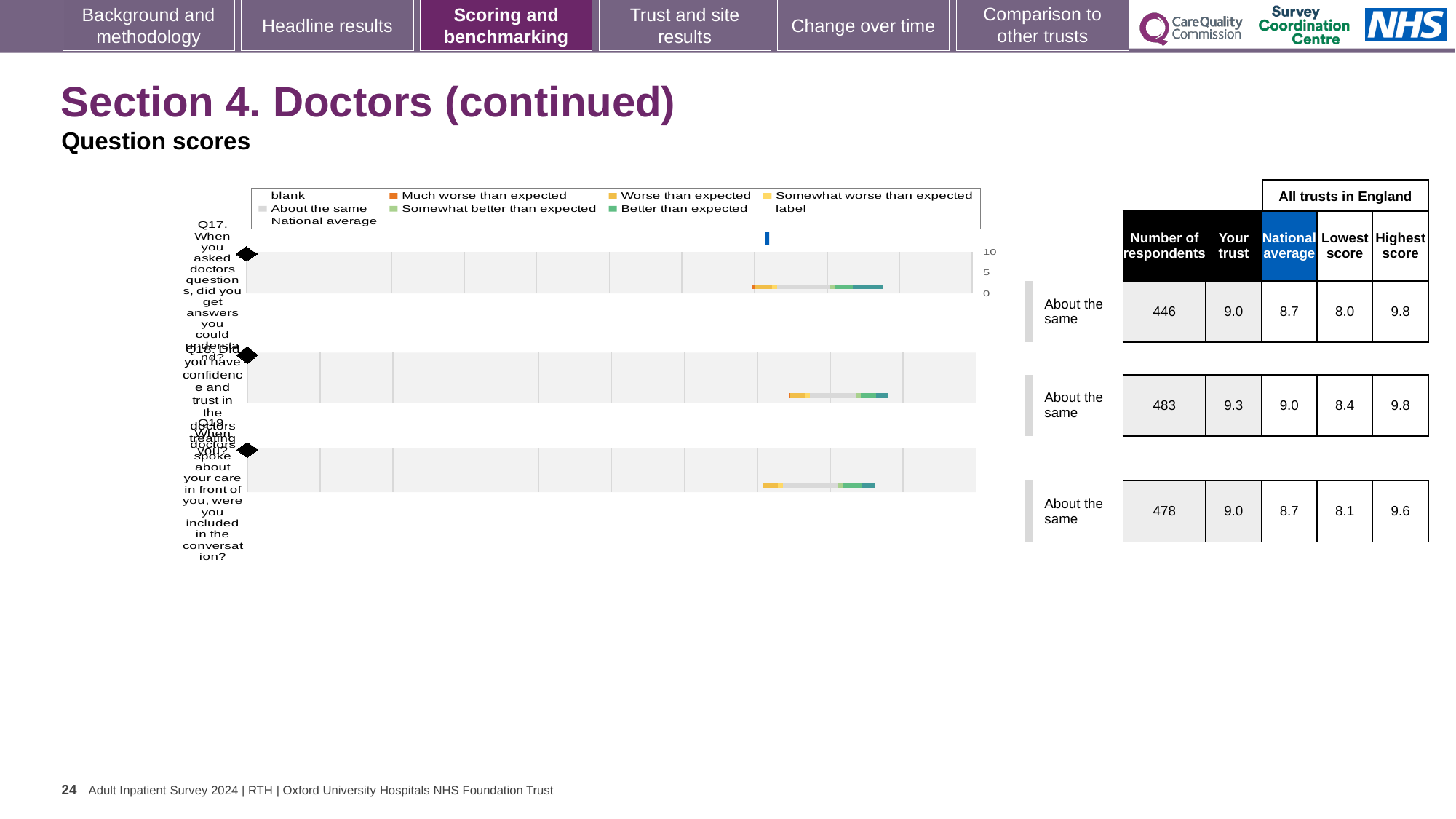
What is the difference between the 'Your trust' score and the national average for Q18? 0.3 What benchmark category is shown for Q17? About the same Which is larger: the national average for Q18 or the national average for Q17? Q18 What is the lowest score across all trusts in England for Q19? 8.1 What is the highest score across all trusts in England for Q18? 9.8 Which question has the lowest number of respondents? Q17 What is the 'Your trust' score for Q18 (Did you have confidence and trust in the doctors treating you?)? 9.3 How many respondents answered Q19 (When doctors spoke about your care in front of you, were you included in the conversation?)? 478 How many questions are plotted on the chart? 3 Which question has the highest 'Your trust' score? Q18 What kind of chart is shown on the slide? Bar chart What is the national average score for Q17 (When you asked doctors questions, did you get answers you could understand?)? 8.7